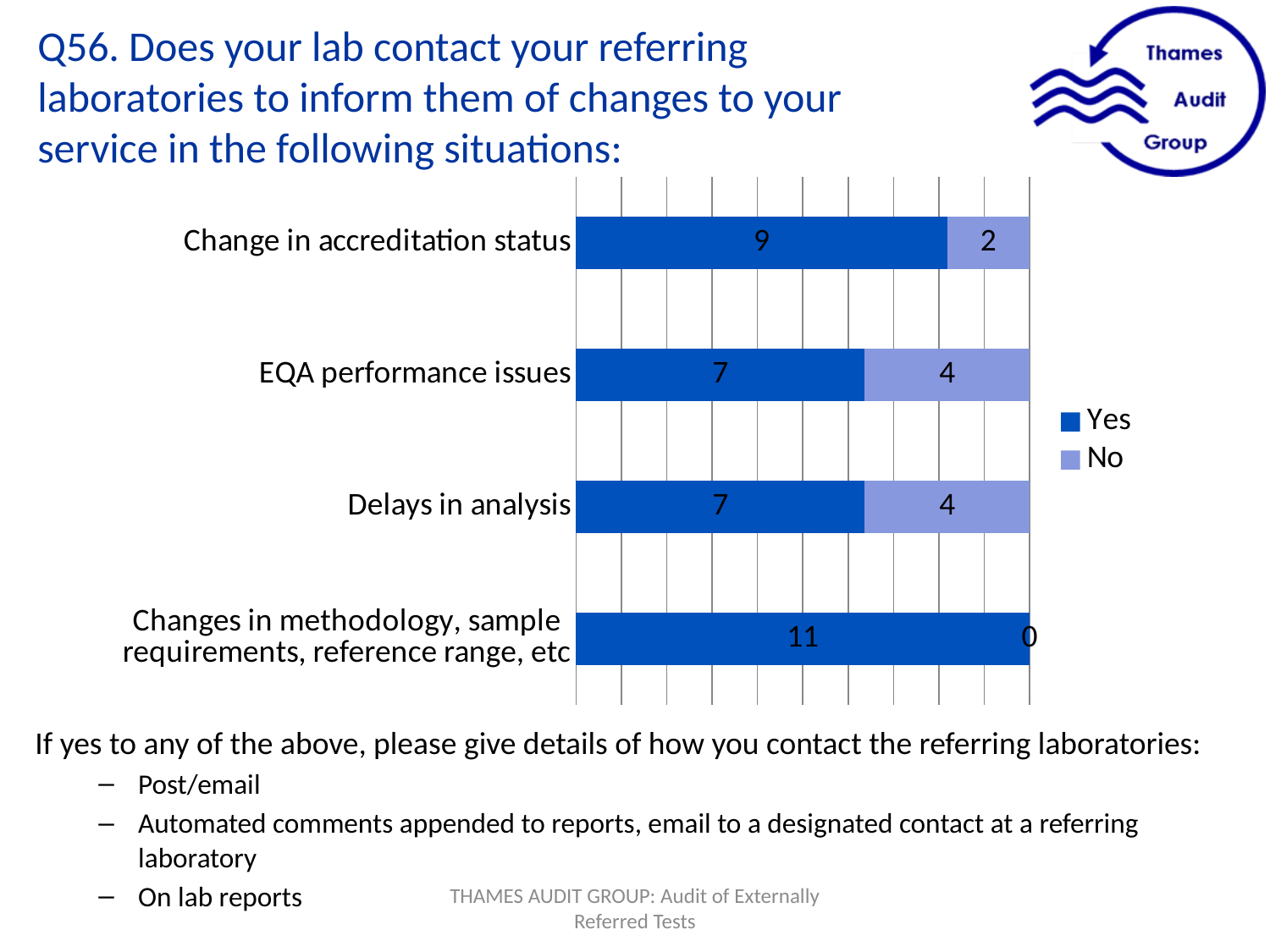
What is the difference between the 'Yes' and 'No' values for 'Change in accreditation status'? 7 What is the 'No' value for 'Delays in analysis'? 4 What is the 'Yes' value for 'Change in accreditation status'? 9 Is the 'Yes' value for 'Change in accreditation status' larger or smaller than the 'Yes' value for 'EQA performance issues'? larger What is the 'No' value for 'EQA performance issues'? 4 What is the total of the stacked bar for 'Delays in analysis'? 11 Which category has the lowest 'No' value? Changes in methodology, sample requirements, reference range, etc What kind of chart is shown on the slide? stacked bar chart Which category has the highest 'Yes' value? Changes in methodology, sample requirements, reference range, etc How many series does the legend list? 2 How many categories are shown on the chart? 4 What is the 'Yes' value for 'Changes in methodology, sample requirements, reference range, etc'? 11